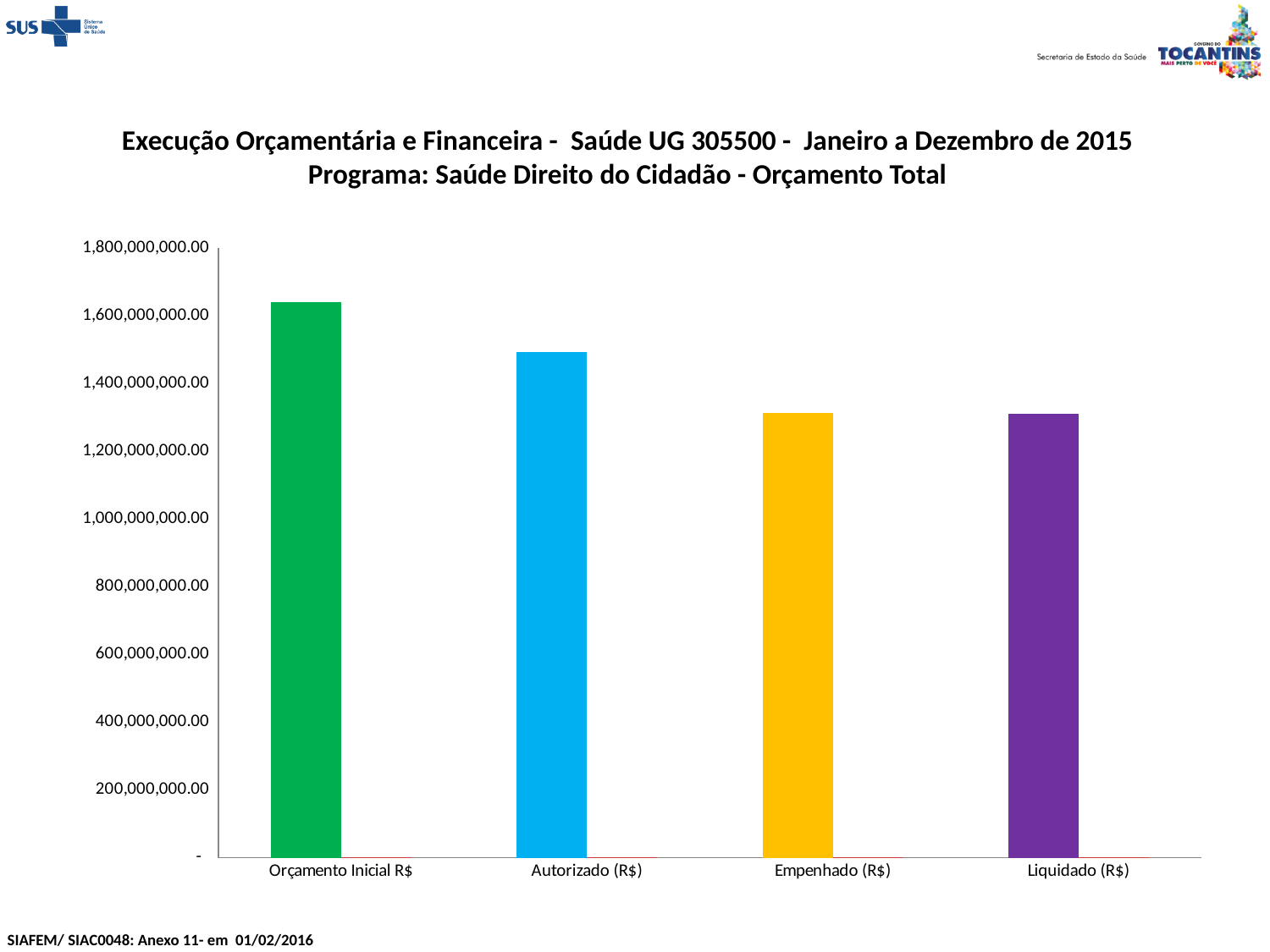
Is the value for Empenhado (R$) greater or less than 1,400,000,000.00? less What kind of chart is shown on the slide? bar chart How many categories are plotted on the x axis? 4 Is the value for Autorizado (R$) greater or less than 1,600,000,000.00? less Which is larger, the value for Orçamento Inicial R$ or the value for Autorizado (R$)? Orçamento Inicial R$ Is the value for Autorizado (R$) greater or less than 1,400,000,000.00? greater Do the values generally rise or fall from left to right along the x axis? fall Which category has the highest value? Orçamento Inicial R$ Which is larger, the value for Autorizado (R$) or the value for Empenhado (R$)? Autorizado (R$) What colour is the bar for Empenhado (R$)? yellow